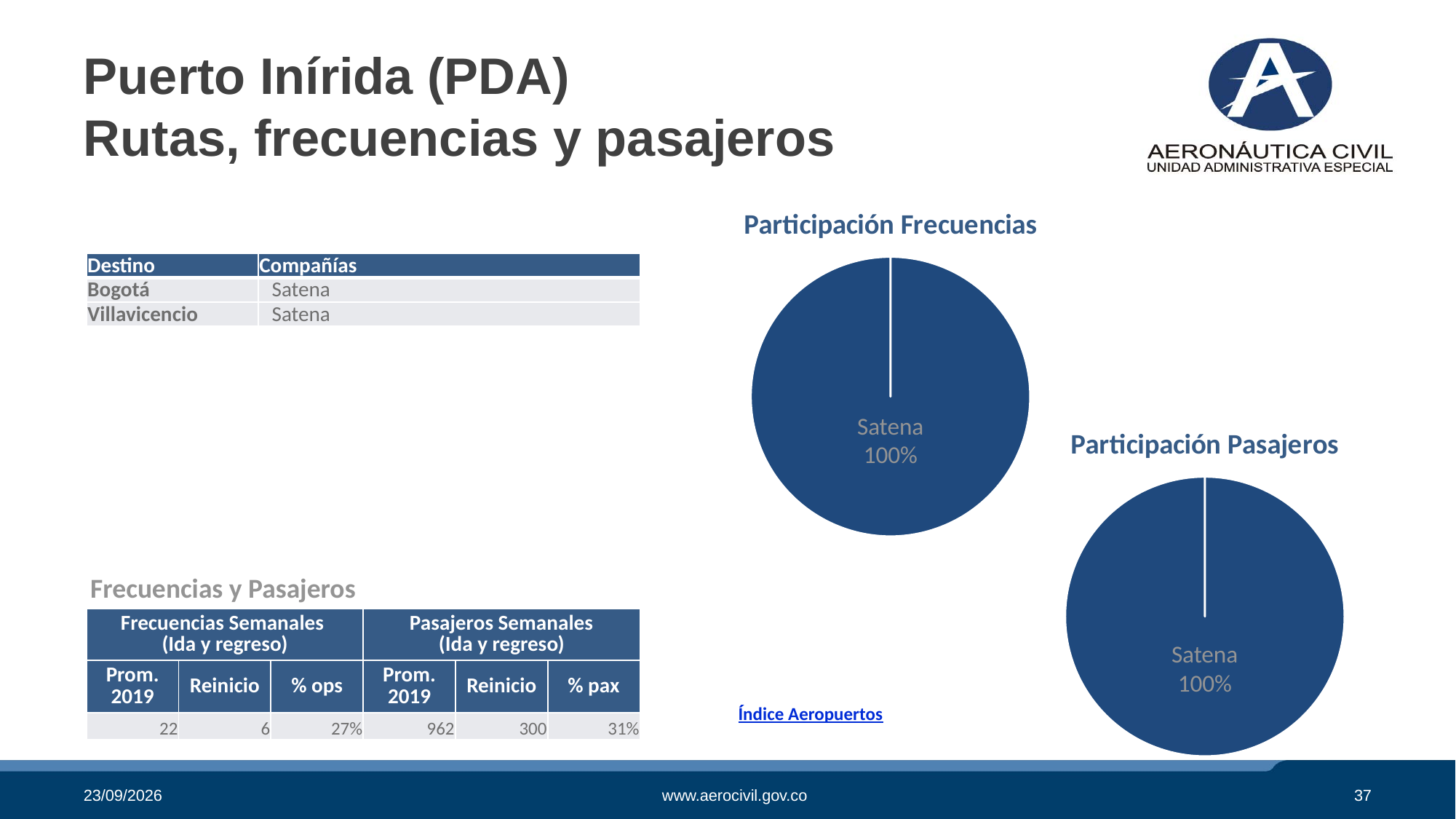
In the "Participación Frecuencias" chart, what share does Satena have? 100% How many slices does the "Participación Frecuencias" pie chart have? 1 How many slices does the "Participación Pasajeros" pie chart have? 1 Which company is shown in the "Participación Pasajeros" chart? Satena What kind of chart is the "Participación Pasajeros" chart? pie chart Which company is shown in the "Participación Frecuencias" chart? Satena In the "Participación Pasajeros" chart, what share does Satena have? 100% How many pie charts are on the slide? 2 What is the title of the pie chart positioned in the lower right of the slide? Participación Pasajeros What kind of chart is the "Participación Frecuencias" chart? pie chart What is the title of the pie chart positioned in the upper right of the slide? Participación Frecuencias